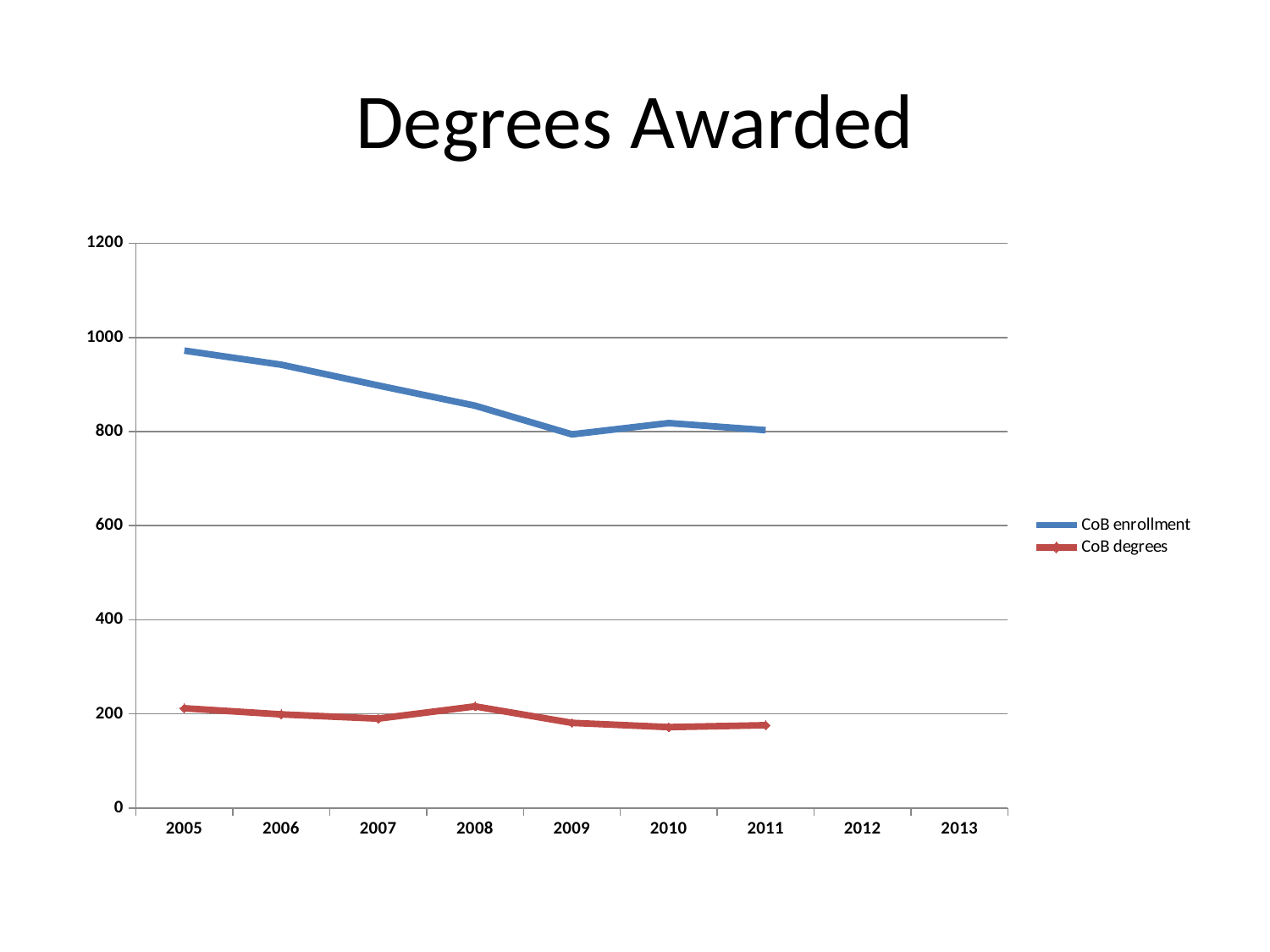
Is the CoB enrollment value for 2005 greater or less than 1000? less How many years have a plotted value for CoB enrollment? 7 Which series is drawn in blue? CoB enrollment Does CoB enrollment rise or fall from 2005 to 2009? fall Which is larger, CoB enrollment in 2005 or CoB enrollment in 2011? 2005 How many series does the legend list? 2 What kind of chart is shown on the slide? line chart How many years are labeled on the x axis? 9 Is the CoB degrees value for 2010 greater or less than 200? less What is the title of the chart? Degrees Awarded Is the CoB enrollment value for 2008 greater or less than 800? greater In which year is CoB enrollment highest? 2005